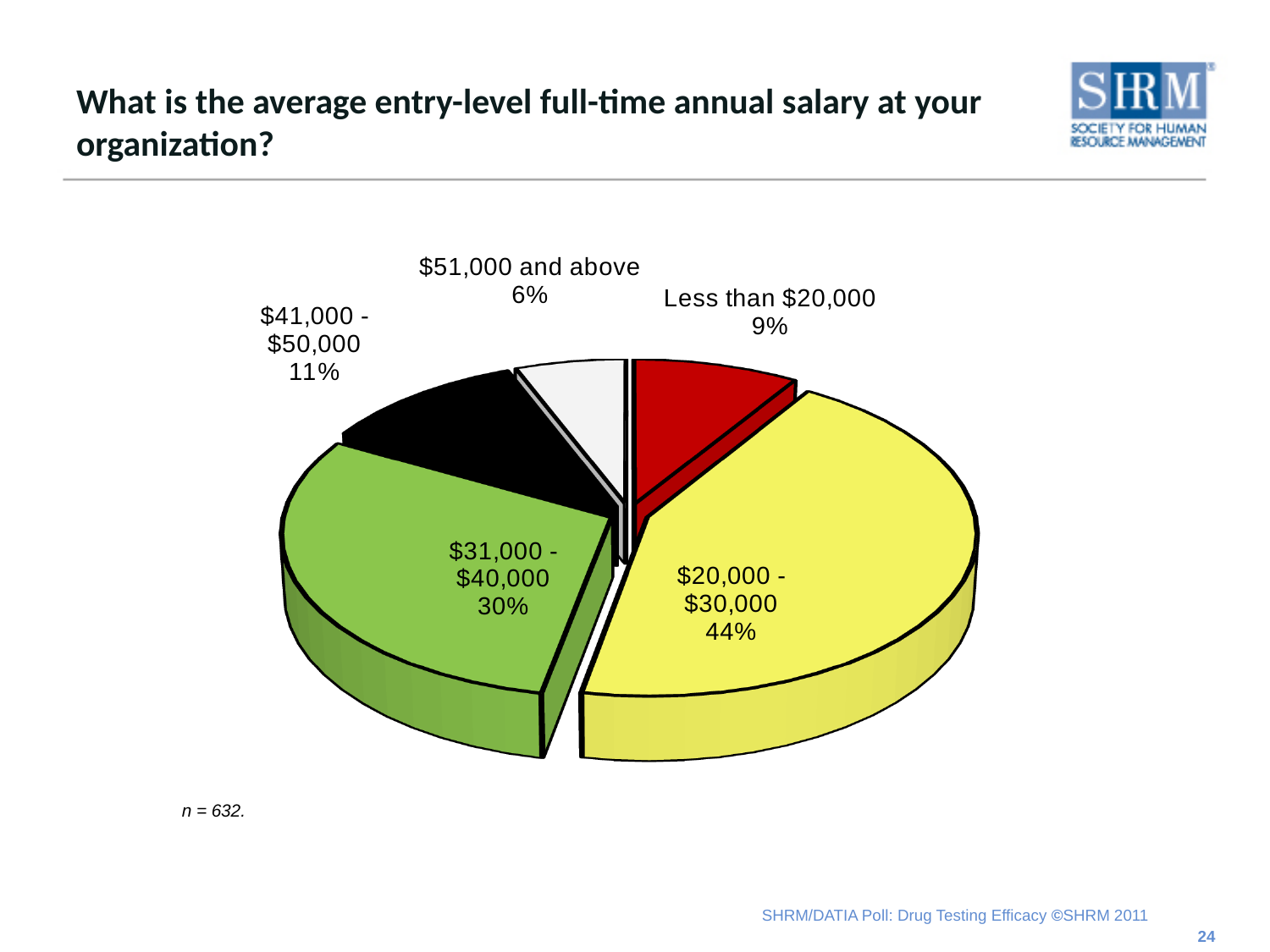
What percentage of organizations report an average entry-level salary of $20,000 - $30,000? 44% What type of chart is shown on the slide? Pie chart How many salary categories are shown in the pie chart? 5 Which salary range has the smallest share of the pie? $51,000 and above Which is larger: the share for $41,000 - $50,000 or the share for Less than $20,000? $41,000 - $50,000 What percentage of organizations report an average entry-level salary of $51,000 and above? 6% What is the combined share of the two lowest salary ranges (Less than $20,000 and $20,000 - $30,000)? 53% What is the difference in percentage points between the $20,000 - $30,000 slice and the $31,000 - $40,000 slice? 14 What percentage of organizations report an average entry-level salary of $31,000 - $40,000? 30% Which salary range has the largest share of the pie? $20,000 - $30,000 What is the sample size (n) noted on the slide? 632 What percentage of organizations report an average entry-level salary of less than $20,000? 9%